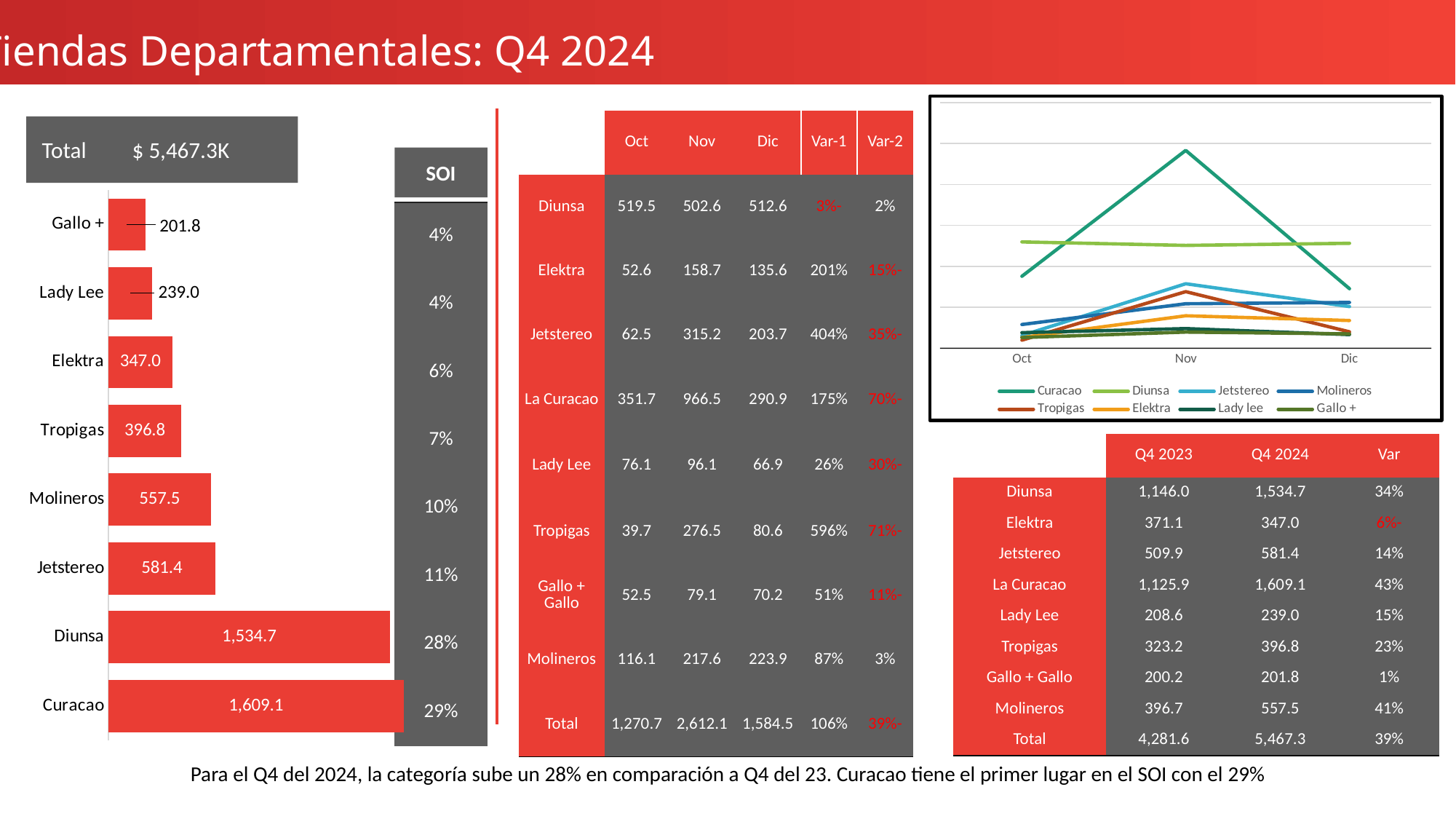
In the line chart in the upper right, which series has the highest value in Nov? Curacao How many categories are shown in the bar chart on the left? 8 In the bar chart on the left, which category has the highest value? Curacao What kind of chart is the chart in the upper right of the slide? line chart In the bar chart on the left, what is the value for Diunsa? 1,534.7 How many series does the legend of the line chart in the upper right list? 8 In the bar chart on the left, which is larger, the value for Jetstereo or the value for Molineros? Jetstereo How many points are on the x axis of the line chart in the upper right? 3 In the bar chart on the left, what is the value for Tropigas? 396.8 What kind of chart is the chart on the left side of the slide? bar chart In the bar chart on the left, what is the difference between the values for Curacao and Diunsa? 74.4 In the bar chart on the left, which category has the lowest value? Gallo +